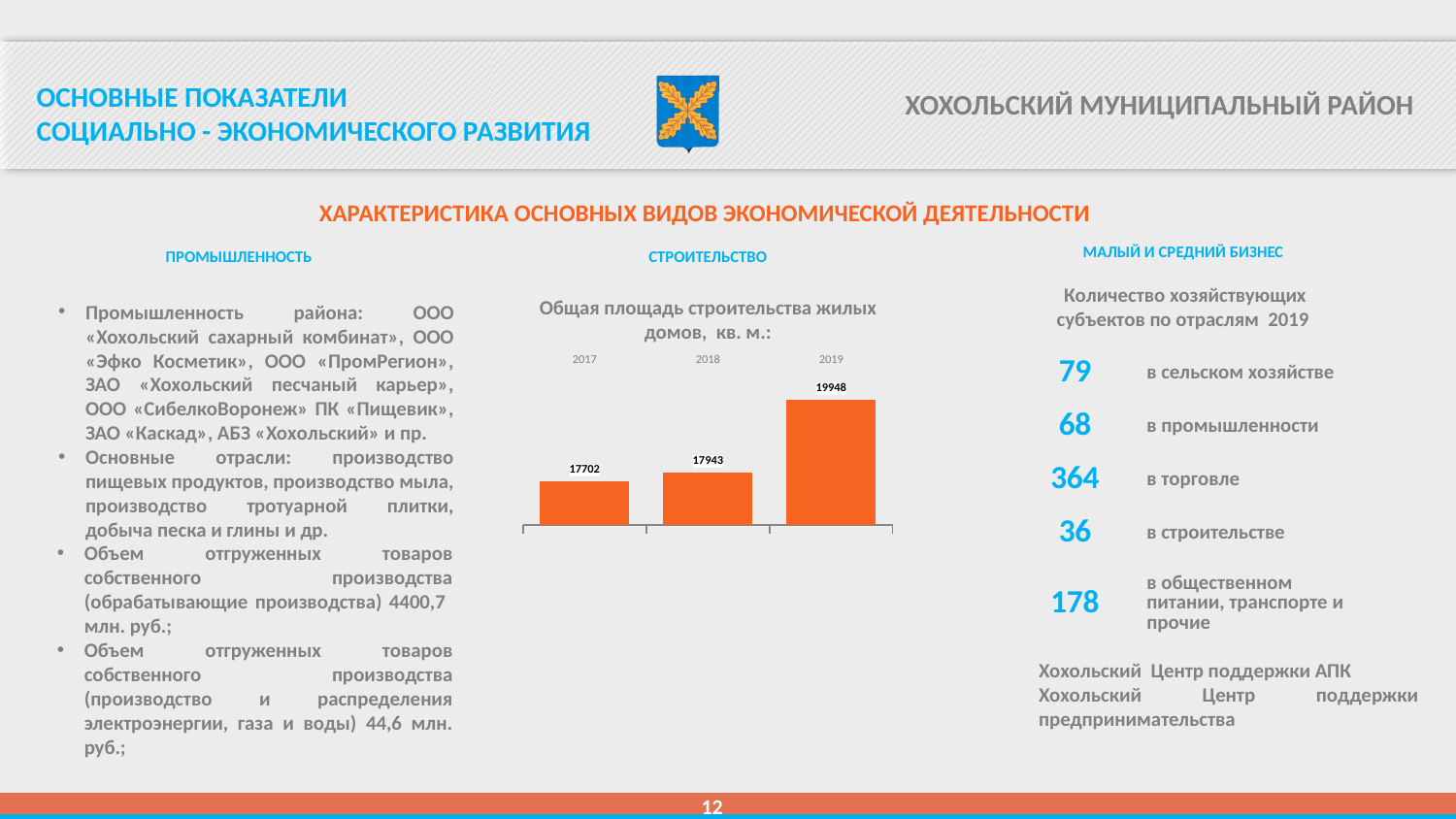
What colour are the bars in the chart "Общая площадь строительства жилых домов, кв. м."? orange What is the value for 2018 in the chart "Общая площадь строительства жилых домов, кв. м."? 17943 Which year has the lowest value in the chart "Общая площадь строительства жилых домов, кв. м."? 2017 How many years are shown in the chart "Общая площадь строительства жилых домов, кв. м."? 3 In the chart "Общая площадь строительства жилых домов, кв. м.", which is larger: the value for 2019 or the value for 2018? 2019 What kind of chart is "Общая площадь строительства жилых домов, кв. м."? bar chart What is the value for 2017 in the chart "Общая площадь строительства жилых домов, кв. м."? 17702 Which year has the highest value in the chart "Общая площадь строительства жилых домов, кв. м."? 2019 What is the difference between the 2019 and 2017 values in the chart "Общая площадь строительства жилых домов, кв. м."? 2246 What is the value for 2019 in the chart "Общая площадь строительства жилых домов, кв. м."? 19948 Do the values in the chart "Общая площадь строительства жилых домов, кв. м." rise or fall from 2017 to 2019? rise What is the difference between the 2018 and 2017 values in the chart "Общая площадь строительства жилых домов, кв. м."? 241